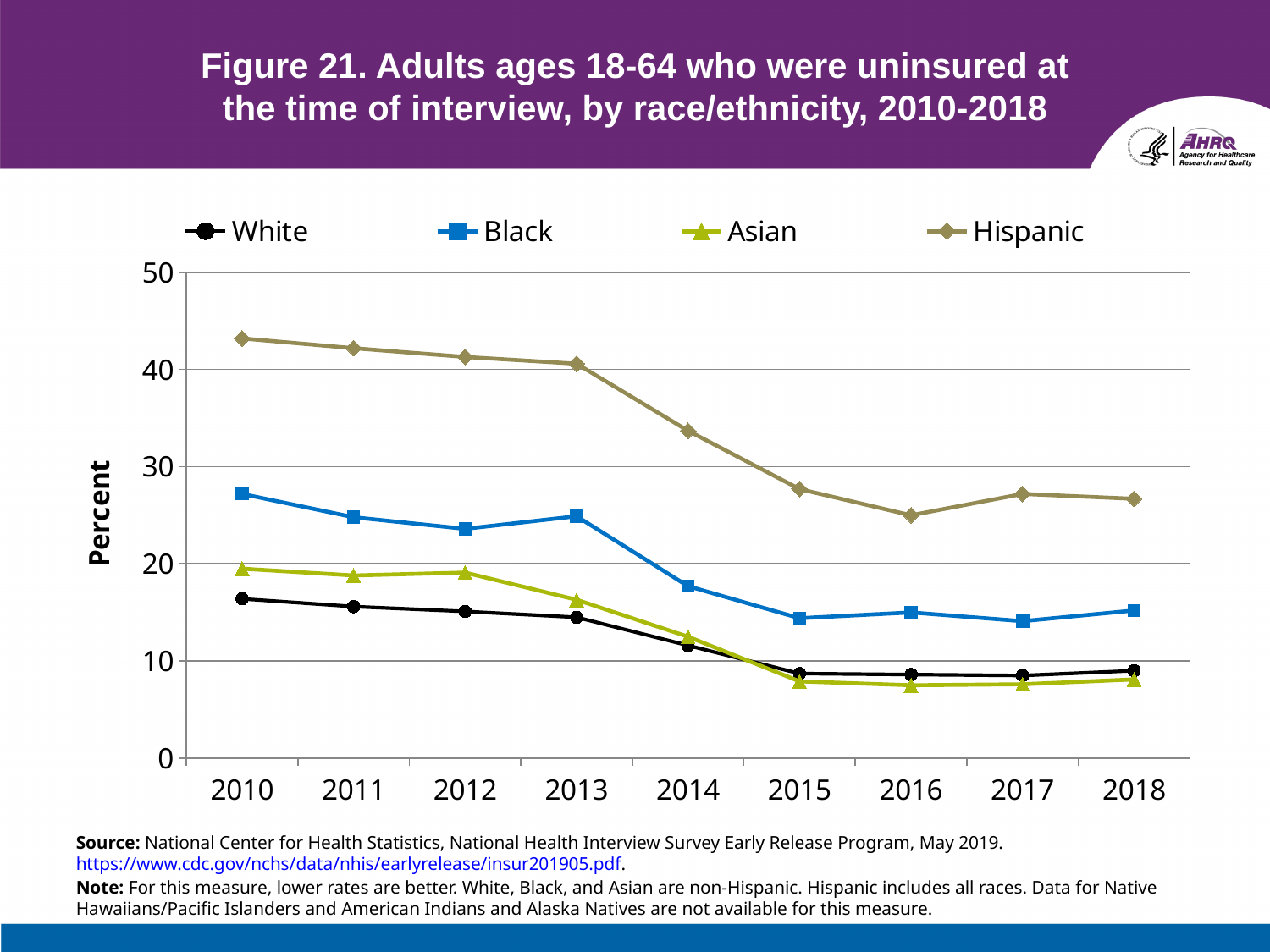
Does the Hispanic uninsured rate rise or fall from 2010 to 2018? fall Is the value for White in 2018 greater or less than 10? less In 2014, which is larger: the value for Black or the value for White? Black How many years are plotted along the x axis? 9 Is the value for Asian in 2012 greater or less than 10? greater Is the value for Hispanic in 2010 greater or less than 40? greater Which race/ethnicity group had the highest uninsured rate in 2010? Hispanic How many series does the legend list? 4 What is the label on the y axis? Percent Which race/ethnicity group had the lowest uninsured rate in 2010? White What kind of chart is shown on the slide? line chart